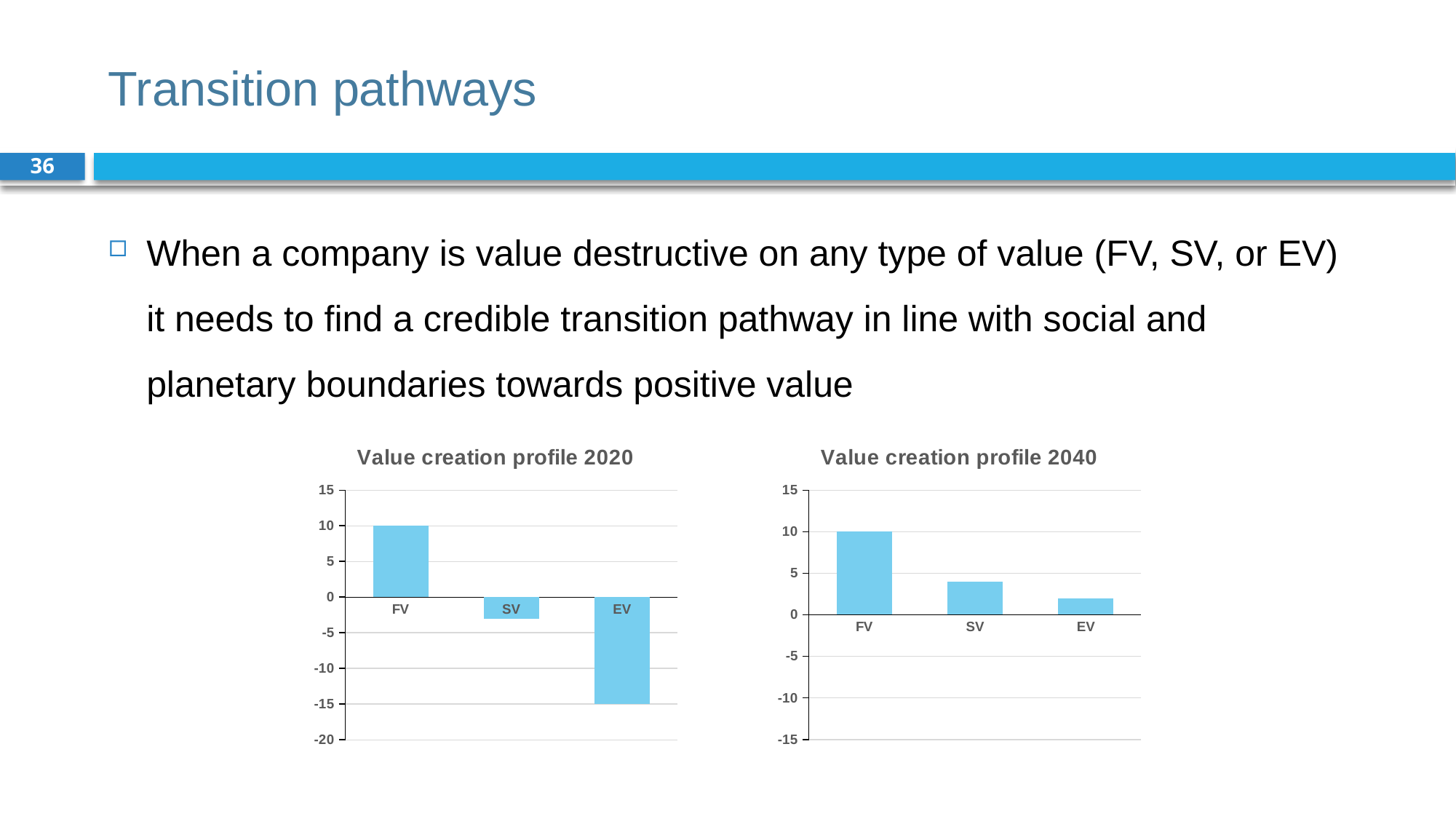
In the 'Value creation profile 2020' chart, is the value for SV greater or less than 0? less In the 'Value creation profile 2040' chart, which is larger, the value for SV or the value for EV? SV In the 'Value creation profile 2040' chart, what is the value for FV? 10 In the 'Value creation profile 2040' chart, which category has the lowest value? EV What kind of chart is the 'Value creation profile 2020' chart? Bar chart In the 'Value creation profile 2040' chart, is the value for SV greater or less than 5? less How many categories are shown in the 'Value creation profile 2040' chart? 3 In the 'Value creation profile 2020' chart, what is the value for EV? -15 In the 'Value creation profile 2020' chart, what is the difference between the values for FV and EV? 25 In the 'Value creation profile 2020' chart, which category has the lowest value? EV In the 'Value creation profile 2040' chart, which category has the highest value? FV In the 'Value creation profile 2020' chart, what is the value for FV? 10